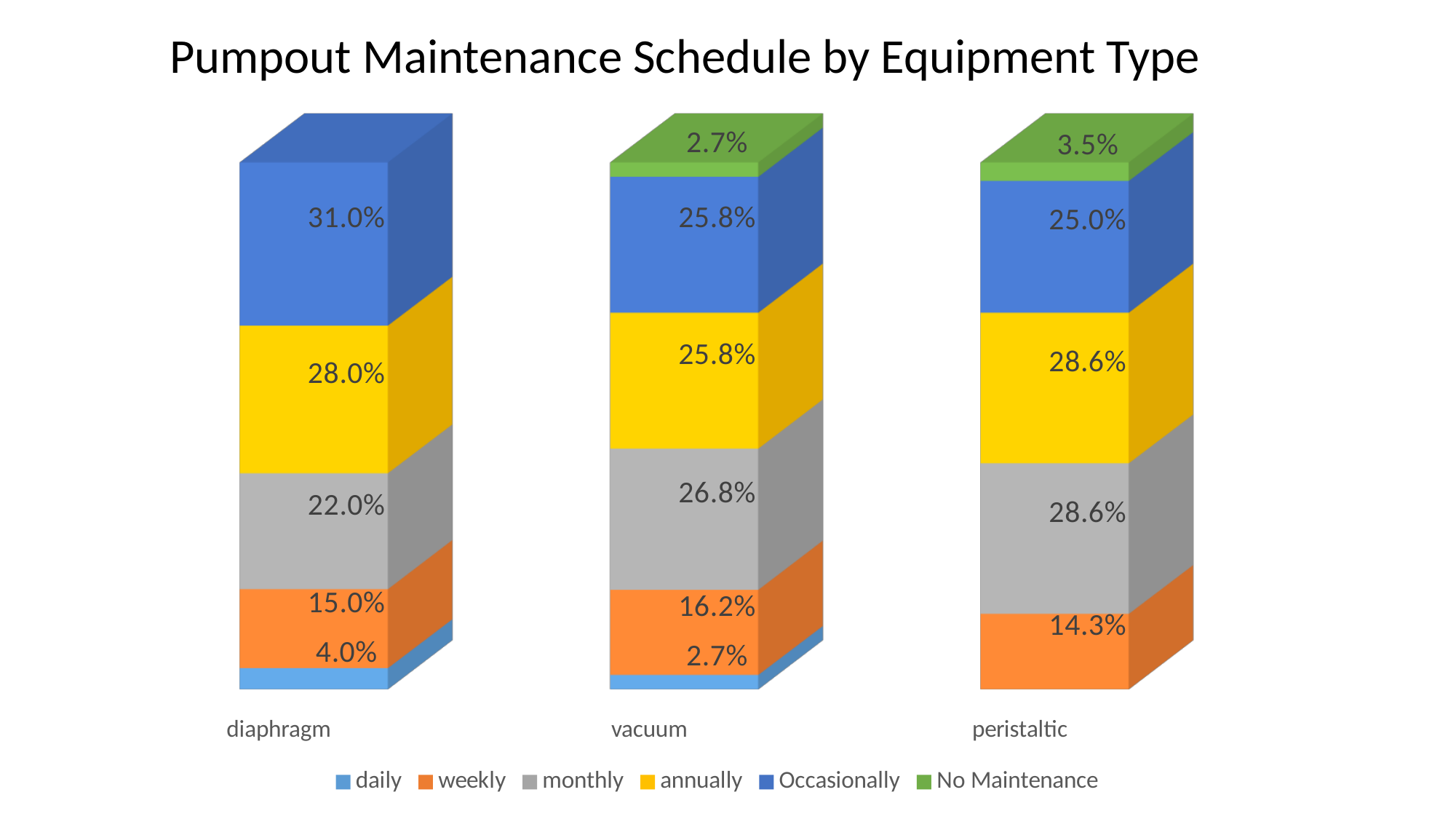
What kind of chart is shown on the slide? Stacked bar chart What is the title of the chart? Pumpout Maintenance Schedule by Equipment Type What is the difference between the annually values for diaphragm and vacuum? 2.2% Which is larger, the monthly value for diaphragm or the monthly value for peristaltic? peristaltic What is the daily value for vacuum? 2.7% How many equipment types are shown on the x axis? 3 What is the No Maintenance value for peristaltic? 3.5% What is the monthly value for vacuum? 26.8% Which equipment type has the highest weekly value? vacuum What is the Occasionally value for diaphragm? 31.0% Which equipment type has the lowest Occasionally value? peristaltic How many series does the legend list? 6